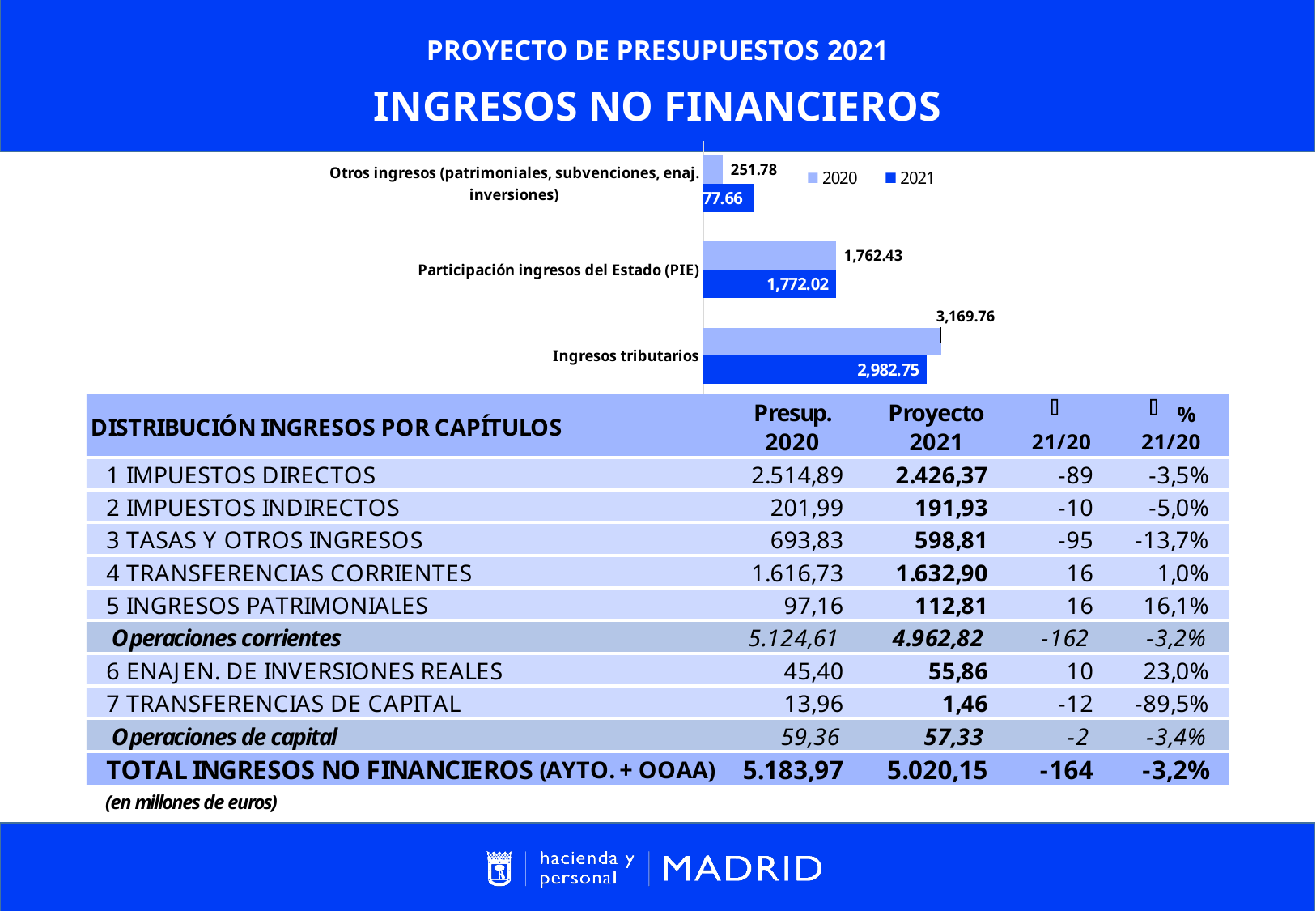
What is the 2021 value for Ingresos tributarios in the chart? 2,982.75 Which category has the highest 2021 value in the chart? Ingresos tributarios How many categories are plotted in the chart? 3 What is the 2021 value for Participación ingresos del Estado (PIE) in the chart? 1,772.02 What is the difference between the 2020 and 2021 values for Ingresos tributarios in the chart? 187.01 What is the 2020 value for Ingresos tributarios in the chart? 3,169.76 Which series in the chart is shown in the darker blue colour? 2021 What is the 2020 value for Otros ingresos (patrimoniales, subvenciones, enaj. inversiones) in the chart? 251.78 What kind of chart is shown on the slide? bar chart Which category has the lowest 2020 value in the chart? Otros ingresos (patrimoniales, subvenciones, enaj. inversiones) For Otros ingresos (patrimoniales, subvenciones, enaj. inversiones), which is larger in the chart: the 2020 value or the 2021 value? 2021 How many series does the chart legend list? 2